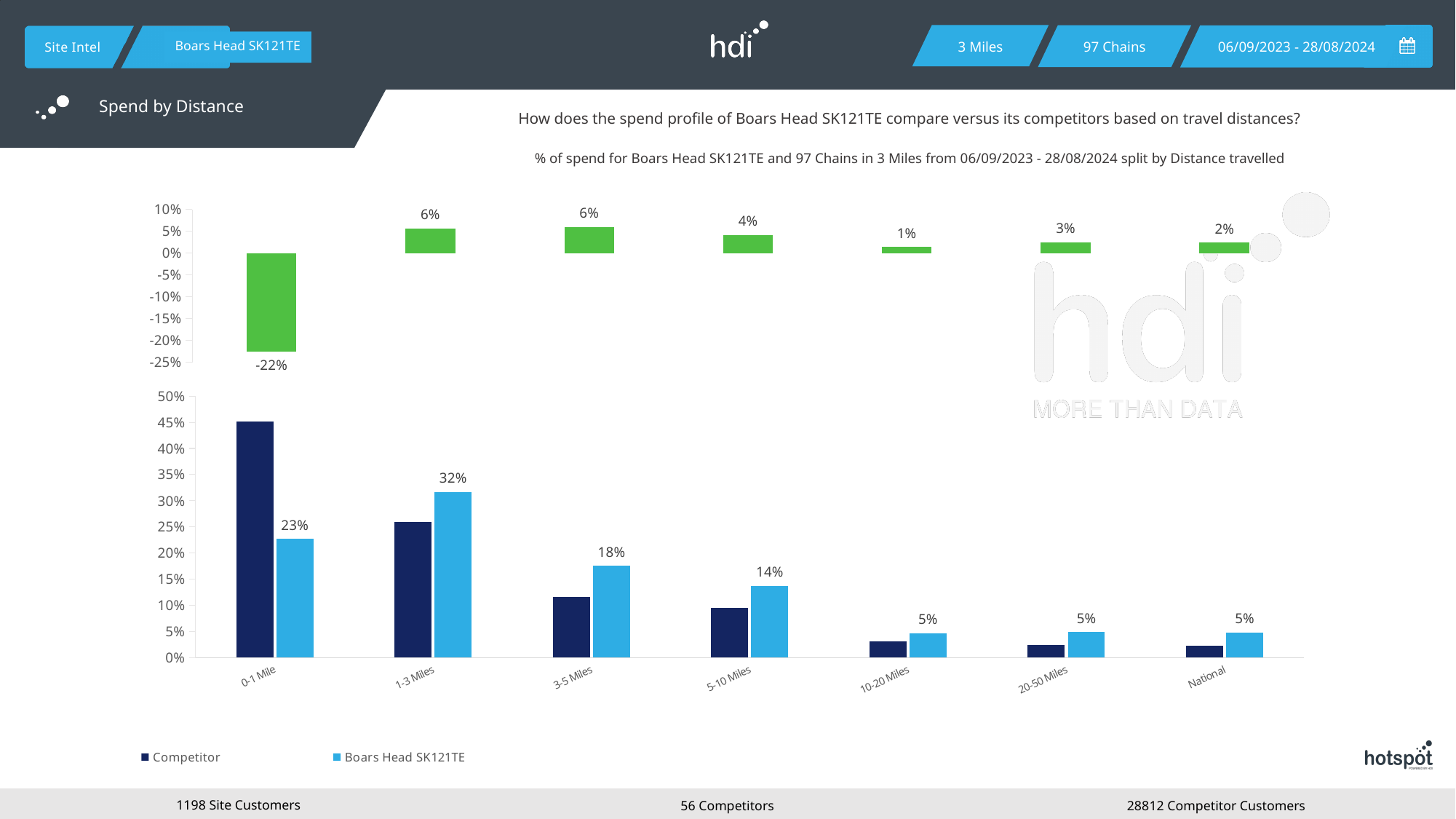
In the top chart, what is the value shown for the 5-10 Miles category? 4% In the bottom chart, what is the value for Boars Head SK121TE in the 1-3 Miles category? 32% In the top chart, what is the value shown for the 0-1 Mile category? -22% In the bottom chart, for the 0-1 Mile category, which series has the larger value: Competitor or Boars Head SK121TE? Competitor In the bottom chart, what is the difference between the Boars Head SK121TE values for 1-3 Miles and 3-5 Miles? 14 percentage points How many distance categories are shown on the x axis of the bottom chart? 7 In the top chart, which category has the lowest value? 0-1 Mile In the bottom chart, is the Competitor value for 0-1 Mile greater or less than 40%? greater What type of chart is the bottom chart? Bar chart In the bottom chart, which distance category has the highest value for Boars Head SK121TE? 1-3 Miles How many series does the legend of the bottom chart list? 2 In the bottom chart, do the Boars Head SK121TE values rise or fall from 1-3 Miles through to National? Fall